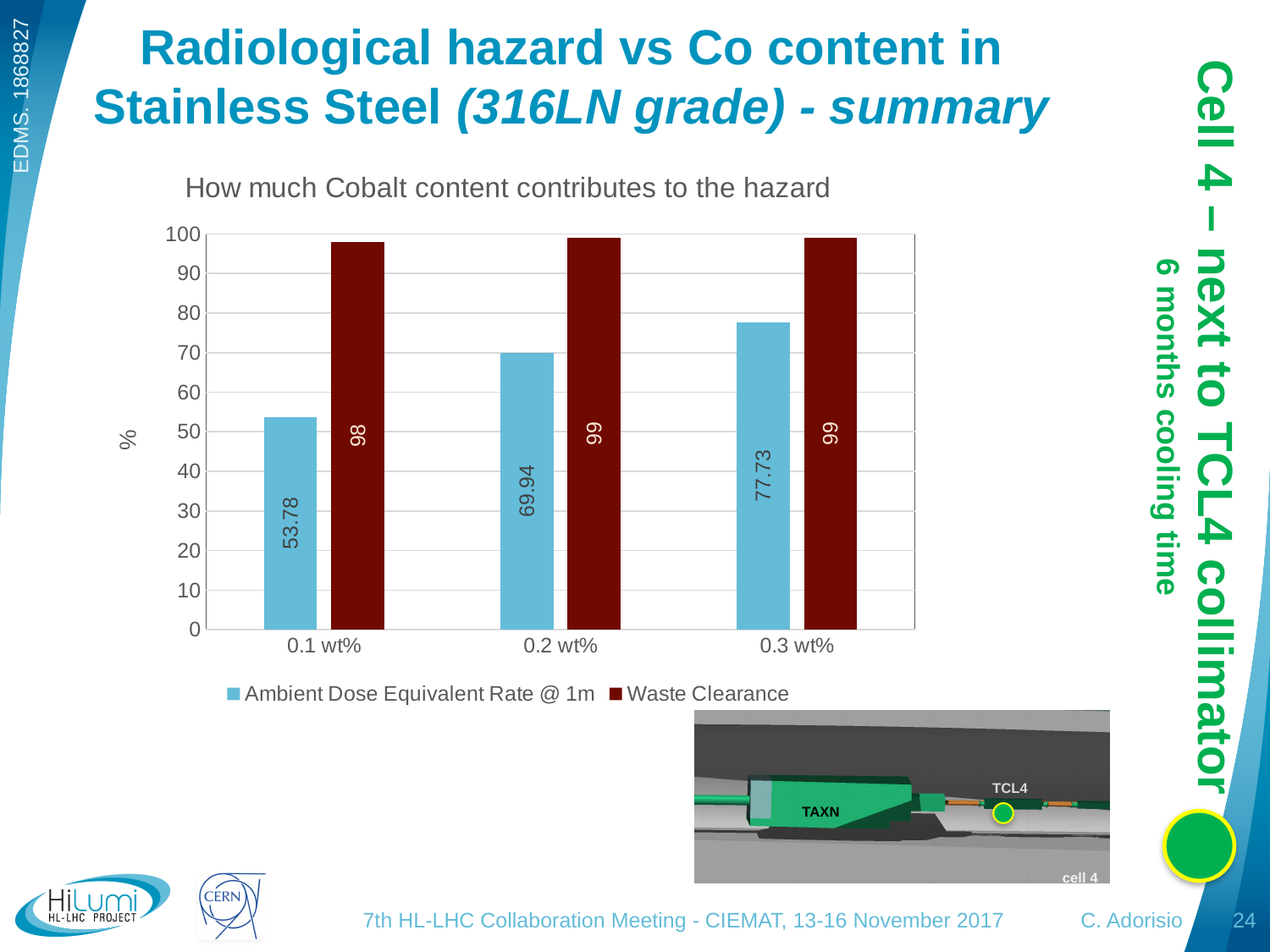
Which is larger for 0.3 wt%: Ambient Dose Equivalent Rate @ 1m or Waste Clearance? Waste Clearance How many series does the legend list? 2 Which category has the highest Ambient Dose Equivalent Rate @ 1m value? 0.3 wt% Do the Ambient Dose Equivalent Rate @ 1m values rise or fall from 0.1 wt% to 0.3 wt%? Rise Which category has the lowest Ambient Dose Equivalent Rate @ 1m value? 0.1 wt% What kind of chart is shown on the slide? Bar chart What is the difference between the Waste Clearance and Ambient Dose Equivalent Rate @ 1m values for 0.2 wt%? 29.06 What is the Waste Clearance value for 0.2 wt%? 99 What is the Ambient Dose Equivalent Rate @ 1m value for 0.3 wt%? 77.73 What is the Waste Clearance value for 0.1 wt%? 98 How many categories are shown on the x axis? 3 What is the Ambient Dose Equivalent Rate @ 1m value for 0.1 wt%? 53.78